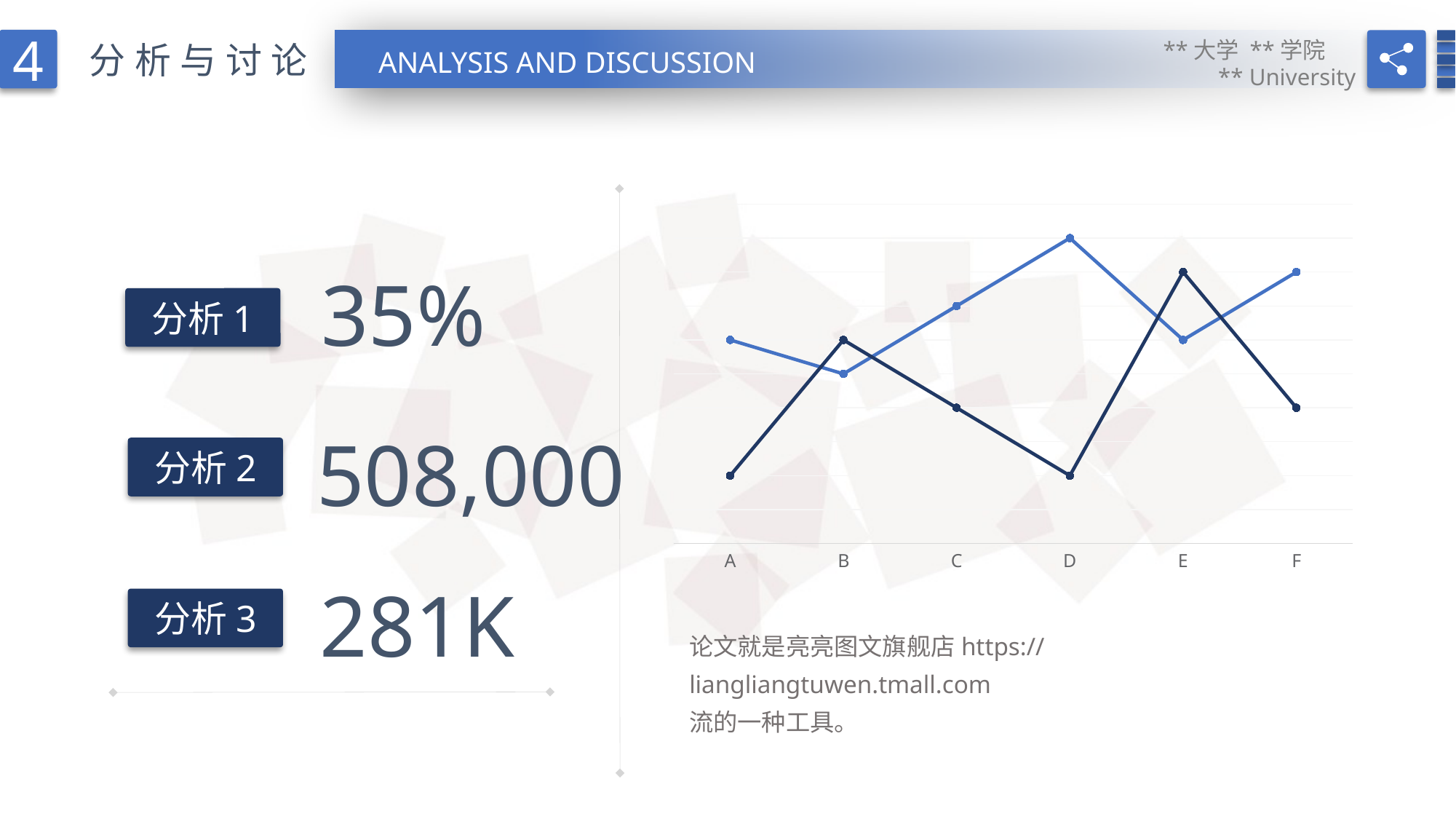
At which category does the light blue line reach its lowest point? B At category F, which line has the higher value, the light blue line or the dark navy line? light blue line At category E, which line has the higher value, the light blue line or the dark navy line? dark navy line What kind of chart is shown on the right side of the slide? line chart At which category does the light blue line reach its highest point? D Does the light blue line rise or fall from category B to category D? rise Does the dark navy line rise or fall from category B to category D? fall At category A, which line has the higher value, the light blue line or the dark navy line? light blue line What are the labels of the categories on the x axis of the line chart? A, B, C, D, E, F At which category does the dark navy line reach its highest point? E How many categories are shown on the x axis of the line chart? 6 How many lines are plotted in the line chart? 2